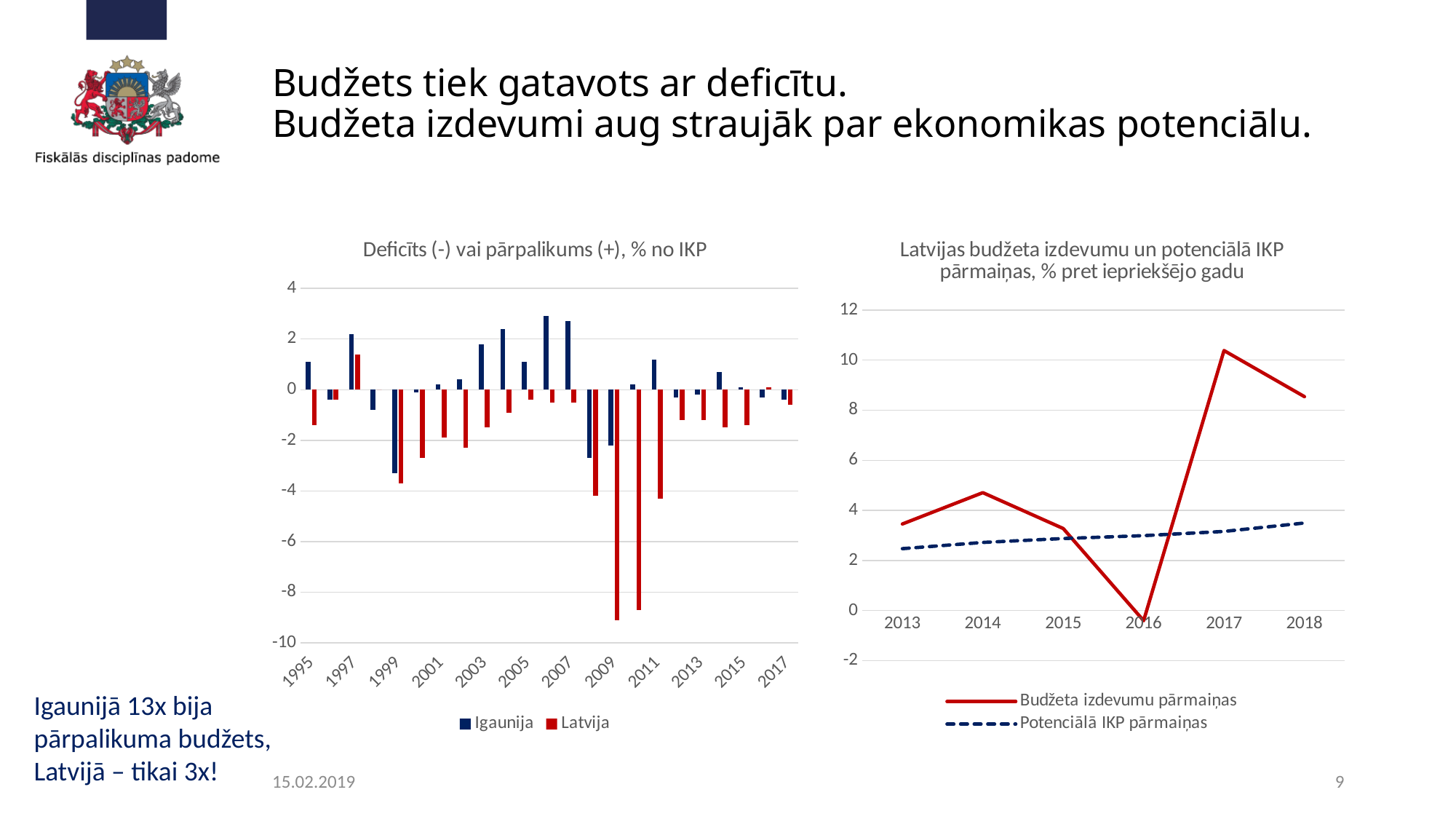
In the left chart, is the value for Latvija in 2009 greater or less than -8? less In the left chart, how many series does the legend list? 2 What kind of chart is the right chart titled "Latvijas budžeta izdevumu un potenciālā IKP pārmaiņas"? line chart In the right chart, does Potenciālā IKP pārmaiņas rise or fall from 2013 to 2018? rise What kind of chart is the left chart titled "Deficīts (-) vai pārpalikums (+), % no IKP"? bar chart In the right chart, how many years are plotted on the x axis? 6 In the right chart, in which year is Budžeta izdevumu pārmaiņas lowest? 2016 In the right chart, in which year is Budžeta izdevumu pārmaiņas highest? 2017 In the left chart, is the value for Igaunija in 2008 greater or less than -2? less In the left chart, which series has the larger value in 1997, Igaunija or Latvija? Igaunija In the right chart, is the value for Budžeta izdevumu pārmaiņas in 2017 greater or less than 10? greater In the right chart, which series is shown as a dashed line? Potenciālā IKP pārmaiņas